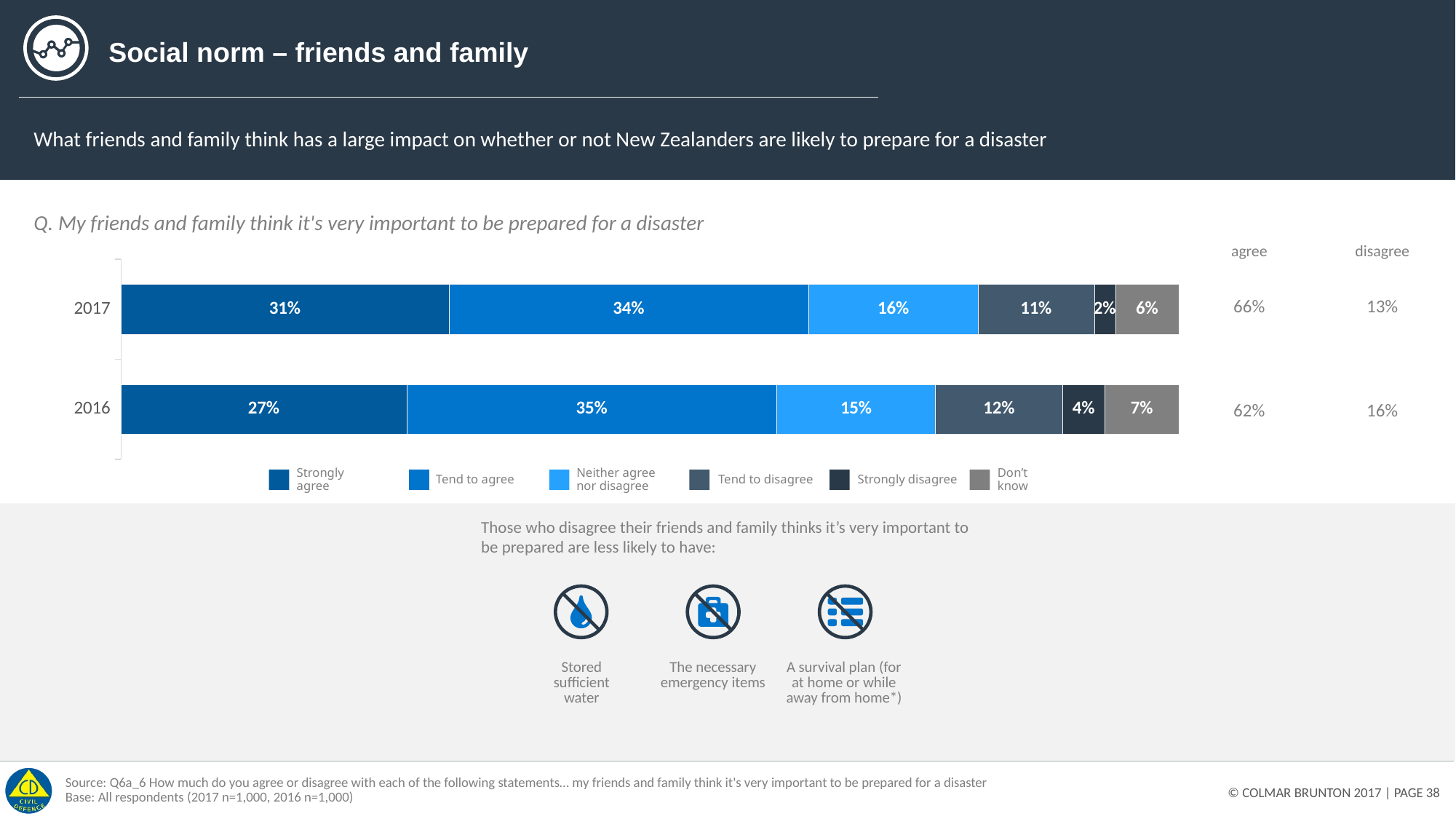
How many years are shown in the chart? 2 What percentage of respondents strongly agreed in 2017? 31% What is the difference in the 'Tend to disagree' percentage between 2016 and 2017? 1 percentage point How many series does the legend list? 6 What is the total 'agree' percentage shown for 2017? 66% Which year had the higher 'Strongly agree' percentage, 2017 or 2016? 2017 Which legend entry is shown in the lightest blue colour? Neither agree nor disagree What percentage answered 'Don't know' in 2017? 6% What percentage of respondents tended to agree in 2016? 35% What is the difference in the 'Strongly agree' percentage between 2017 and 2016? 4 percentage points What kind of chart is shown on the slide? Stacked bar chart What percentage strongly disagreed in 2016? 4%